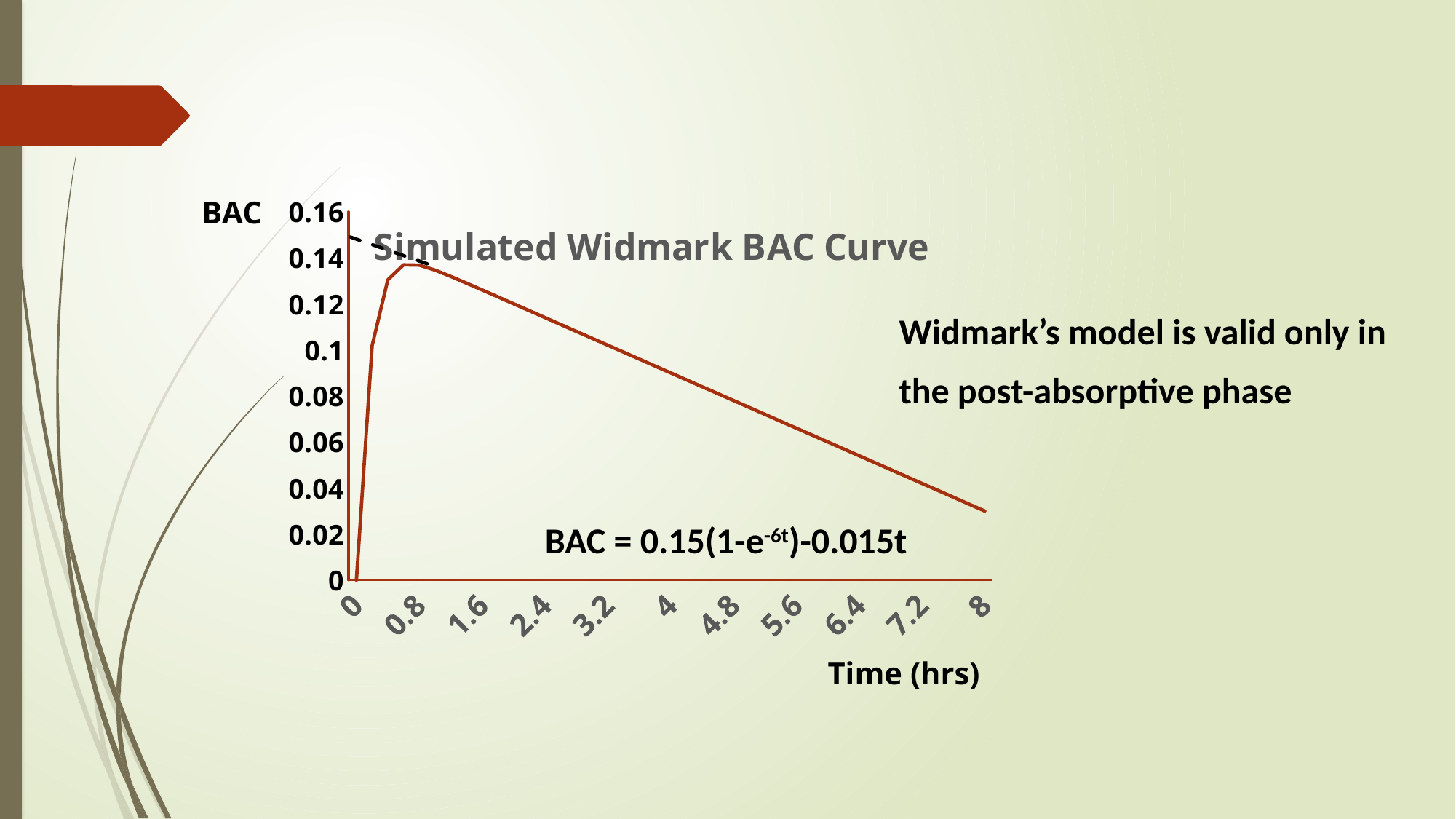
Which is larger, the BAC value at 1.6 hrs or at 7.2 hrs? 1.6 hrs What is the title of the chart? Simulated Widmark BAC Curve What type of chart is shown on the slide? line chart Is the BAC value at 6.4 hrs greater or less than 0.08? less Is the BAC value at 0.8 hrs greater or less than 0.12? greater At which time (hrs) is the BAC value lowest? 0 What is the label of the x axis of the chart? Time (hrs) Do the BAC values rise or fall along the x axis from 0.8 hrs to 8 hrs? fall What is the BAC value at time 0 hrs? 0 Is the BAC value at 1.6 hrs greater or less than 0.1? greater